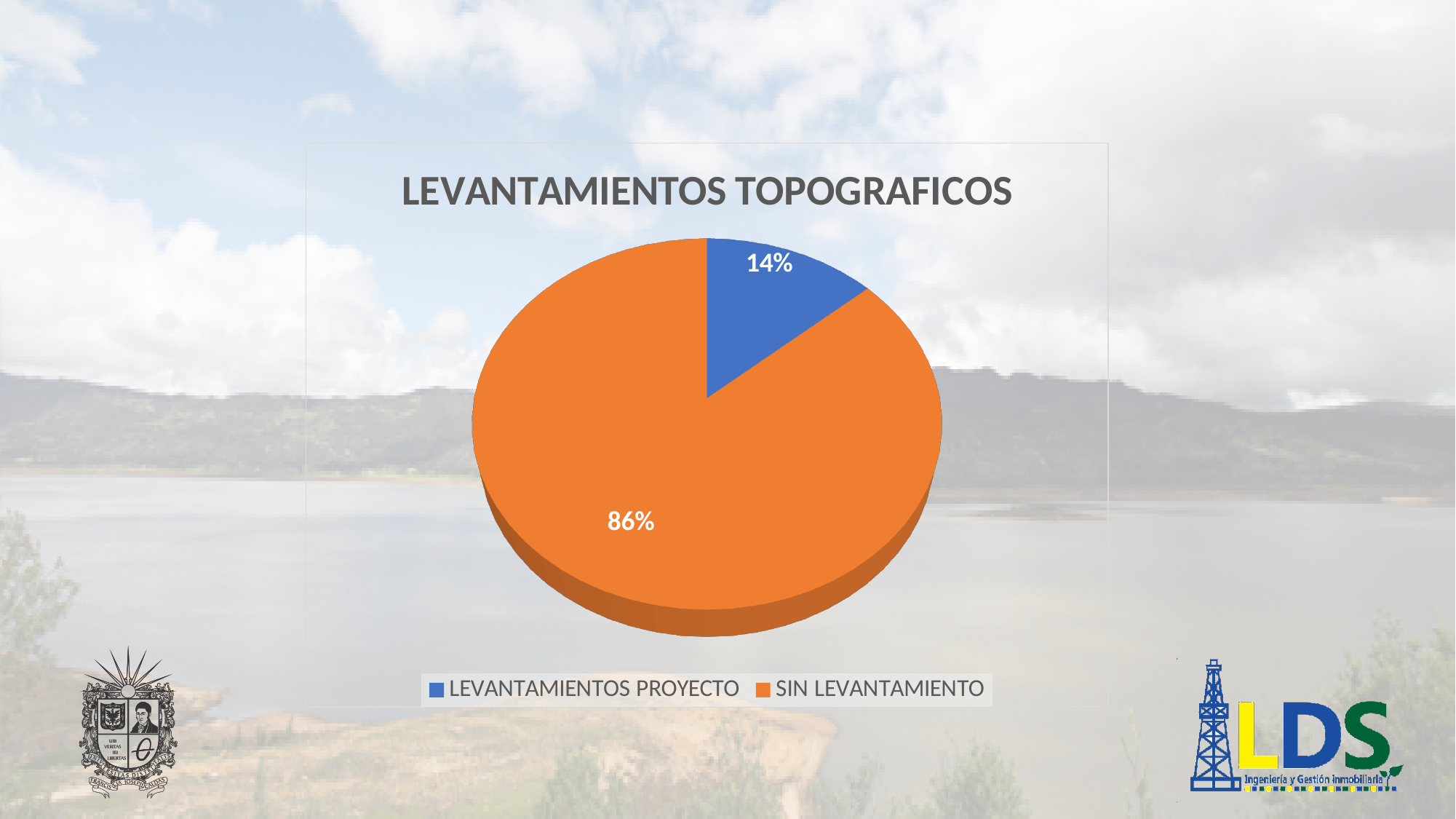
Which category has the smallest share of the pie? LEVANTAMIENTOS PROYECTO What is the difference in percentage points between SIN LEVANTAMIENTO and LEVANTAMIENTOS PROYECTO? 72 Which category has the largest share of the pie? SIN LEVANTAMIENTO What share of the pie does LEVANTAMIENTOS PROYECTO represent? 14% What percentage is shown for LEVANTAMIENTOS PROYECTO? 14% What is the title of the chart? LEVANTAMIENTOS TOPOGRAFICOS How many slices does the pie chart have? 2 What percentage is shown for SIN LEVANTAMIENTO? 86% What colour is the slice for SIN LEVANTAMIENTO? orange What kind of chart is shown on the slide? pie chart How many entries does the legend list? 2 Which is larger, the share for LEVANTAMIENTOS PROYECTO or the share for SIN LEVANTAMIENTO? SIN LEVANTAMIENTO